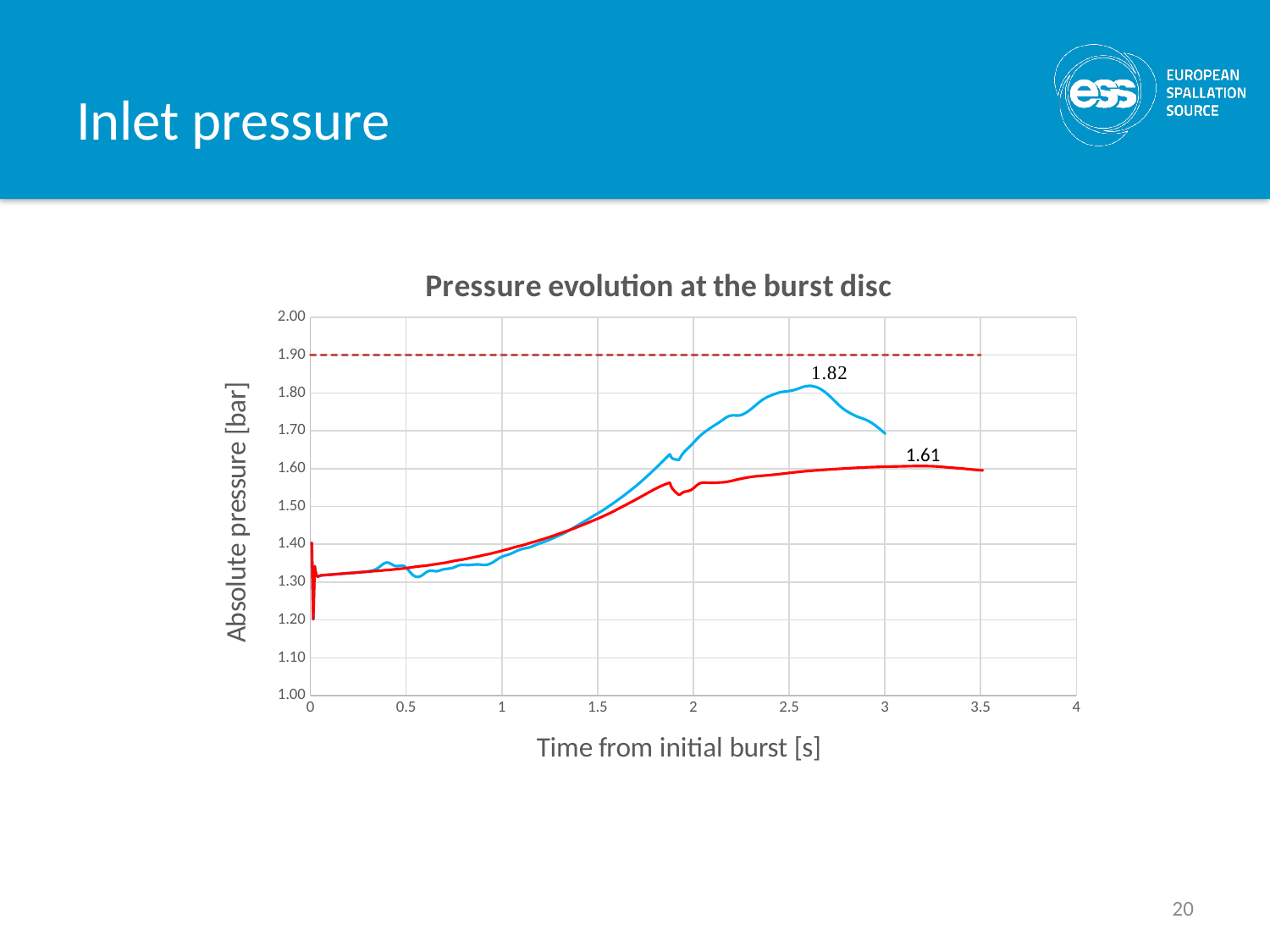
What kind of chart is shown on the slide? Line chart What is the difference between the labelled peak of the blue line and the labelled peak of the red line? 0.21 What is the peak value labelled on the red line? 1.61 What is the title of the chart? Pressure evolution at the burst disc Is the value of the blue line at 2.5 s greater or less than 1.70? greater Is the value of the blue line at 1 s greater or less than 1.40? less What is the label of the vertical axis? Absolute pressure [bar] Does the red line generally rise or fall between 0.5 s and 2.5 s? Rise Which line reaches the higher labelled peak, the blue line or the red line? Blue line Is the value of the red line at 3.5 s greater or less than 1.70? less How many solid data lines are plotted on the chart? 2 What is the peak value labelled on the blue line? 1.82